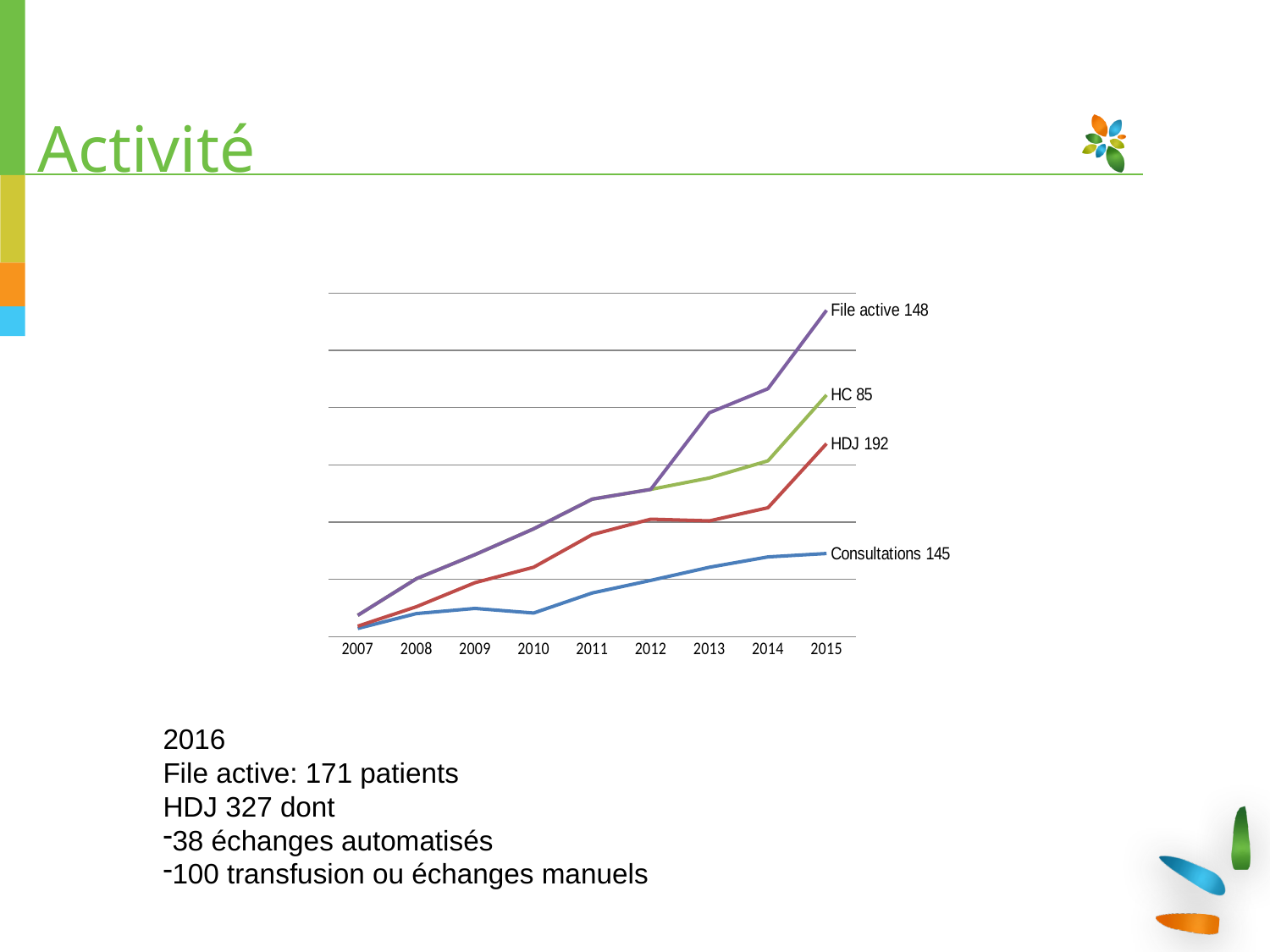
What value is labelled for HC at the end of the line? 85 What kind of chart is shown on the slide? line chart How many series (lines) are plotted in the chart? 4 Does the File active line rise or fall from 2007 to 2015? rises What value is labelled for File active at the end of the line? 148 What is the difference between the labelled values for HDJ (192) and Consultations (145)? 47 How many years are shown on the x axis of the chart? 9 What value is labelled for Consultations at the end of the line? 145 What is the first year shown on the x axis? 2007 What value is labelled for HDJ at the end of the line? 192 In which year does the HC line first appear on the chart? 2012 Does the Consultations line rise or fall from 2010 to 2015? rises